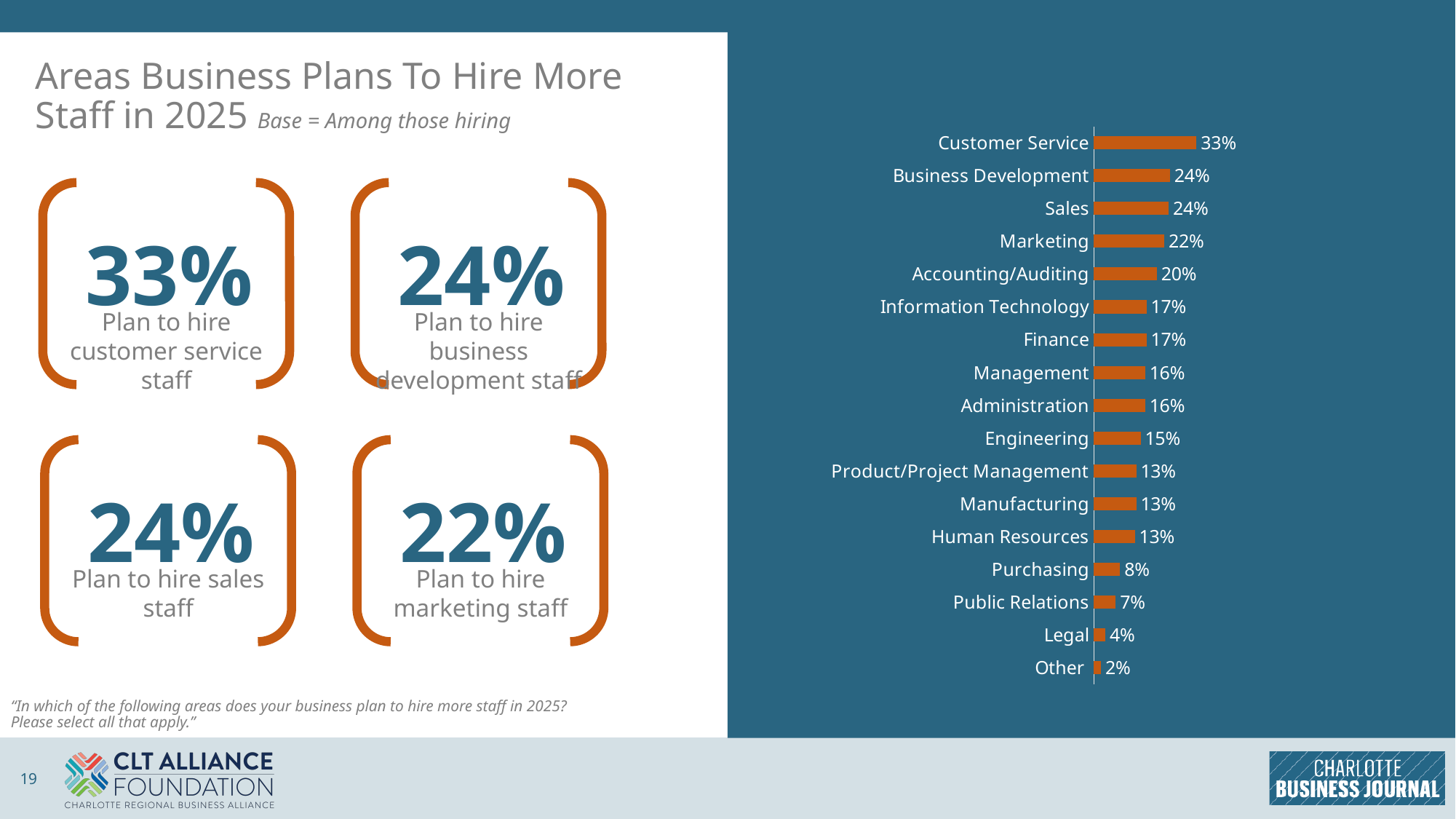
What is the value shown for Engineering? 15% Which is larger, the value for Information Technology or the value for Human Resources? Information Technology What is the difference between the values for Customer Service and Marketing? 11% Which area has the highest percentage of businesses planning to hire? Customer Service Which category has the lowest value in the chart? Other What is the value shown for Accounting/Auditing? 20% What percentage of businesses plan to hire more Customer Service staff? 33% How many categories are shown in the bar chart? 17 What is the title of the slide's chart? Areas Business Plans To Hire More Staff in 2025 What is the value shown for Legal? 4% What type of chart is shown on the slide? Bar chart What is the difference between the values for Purchasing and Public Relations? 1%